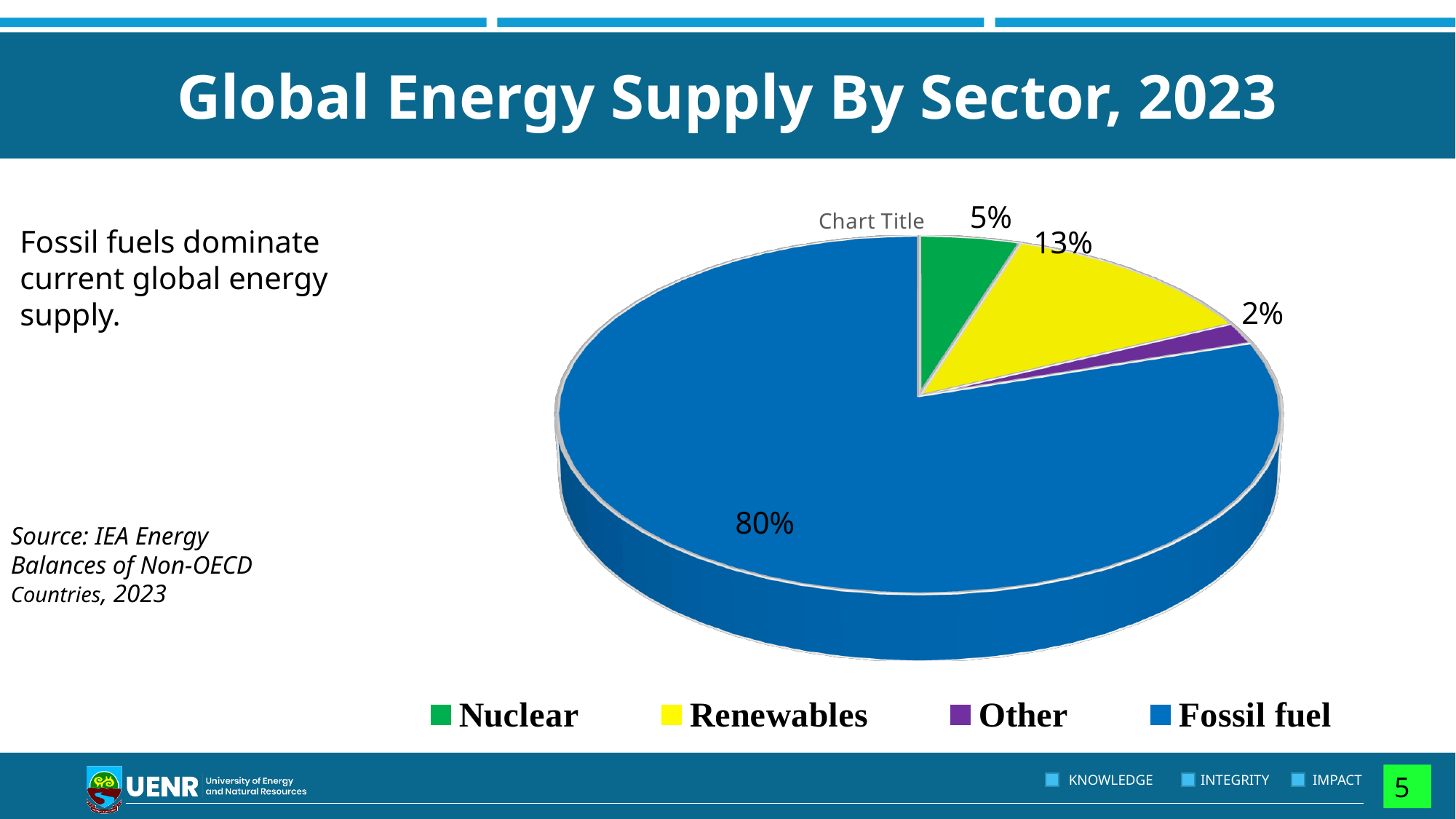
What is the difference in percentage points between the Fossil fuel slice and the Renewables slice? 67 What kind of chart is shown on the slide? Pie chart Which sector has the largest slice of the pie chart? Fossil fuel What percentage of the pie chart is Nuclear? 5% What percentage of the pie chart is labelled Other? 2% What is the combined share of Nuclear and Renewables in the pie chart? 18% What share of global energy supply does Fossil fuel account for in the pie chart? 80% What percentage of the pie chart is Renewables? 13% Which sector has the smallest slice of the pie chart? Other Which is larger, the Renewables slice or the Nuclear slice? Renewables What colour is the Renewables slice in the pie chart? Yellow How many slices does the pie chart have? 4